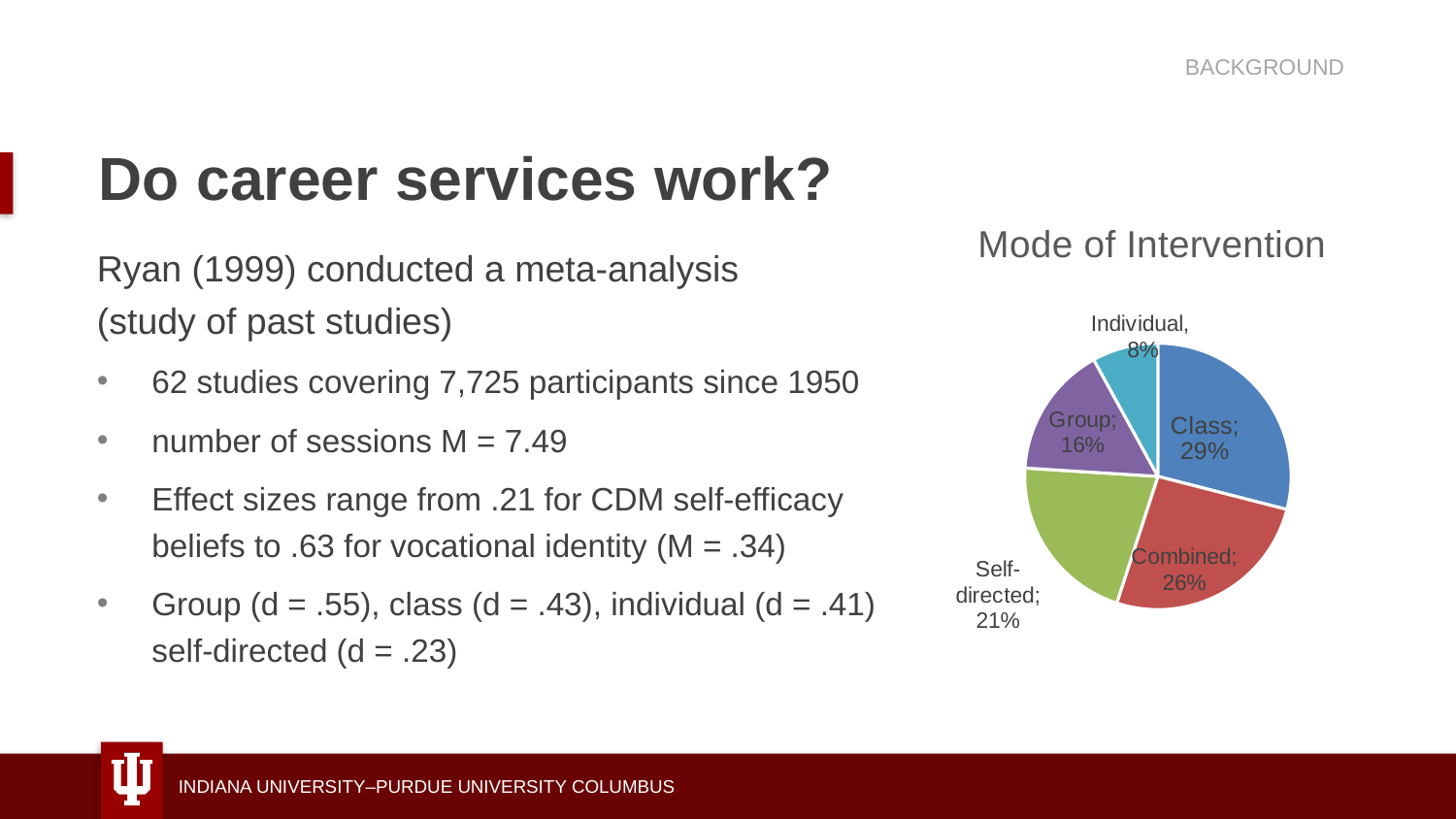
What is the difference in percentage points between the Class slice and the Group slice? 13 What is the title of the chart on the slide? Mode of Intervention How many slices does the pie chart have? 5 Which mode of intervention has the largest share of the pie? Class What percentage of the pie does Individual account for? 8% Which slice is larger, Combined or Self-directed? Combined What percentage of the pie does Group account for? 16% What percentage of the pie does Class account for? 29% What percentage of the pie does Combined account for? 26% Which mode of intervention has the smallest share of the pie? Individual What percentage of the pie does Self-directed account for? 21% What kind of chart is shown on the slide? pie chart